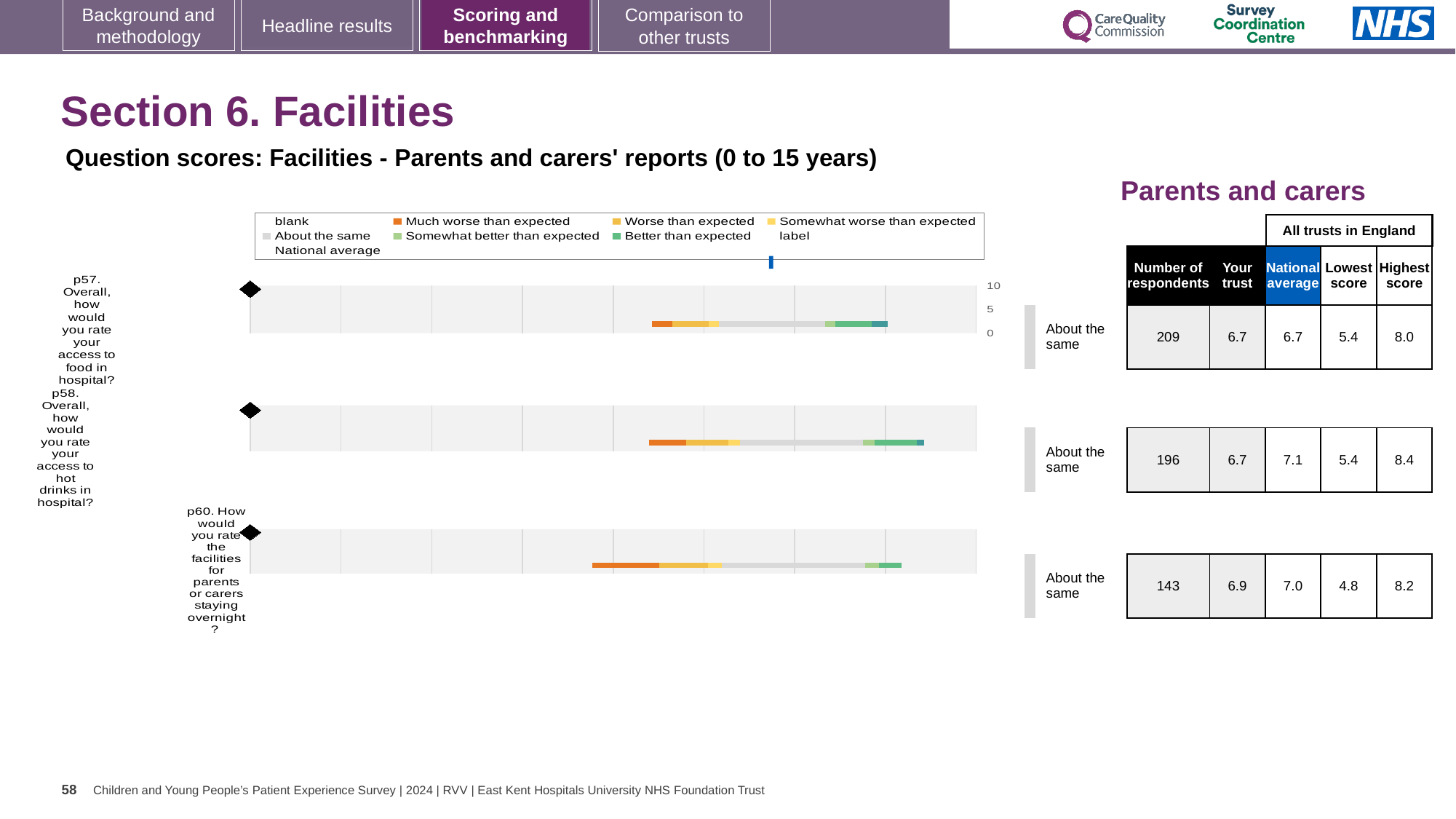
What is the 'Your trust' score for p60 (facilities for parents or carers staying overnight)? 6.9 What is the national average score for p58 (access to hot drinks in hospital)? 7.1 What benchmark category is shown for p57? About the same What is the difference between the highest score and the lowest score for p57? 2.6 What is the lowest score across all trusts in England for p60? 4.8 Which question has the highest 'Highest score' value among all trusts in England? p58 (8.4) What is the number of respondents for p57 (access to food in hospital)? 209 Which question has the lowest 'Lowest score' value among all trusts in England? p60 (4.8) What is the title of the chart section on the slide? Question scores: Facilities - Parents and carers' reports (0 to 15 years) What kind of chart is used to show the question scores on this slide? bar chart For p58, which is larger: the 'Your trust' score or the national average? National average How many questions (p57, p58, p60) are plotted on the slide? 3